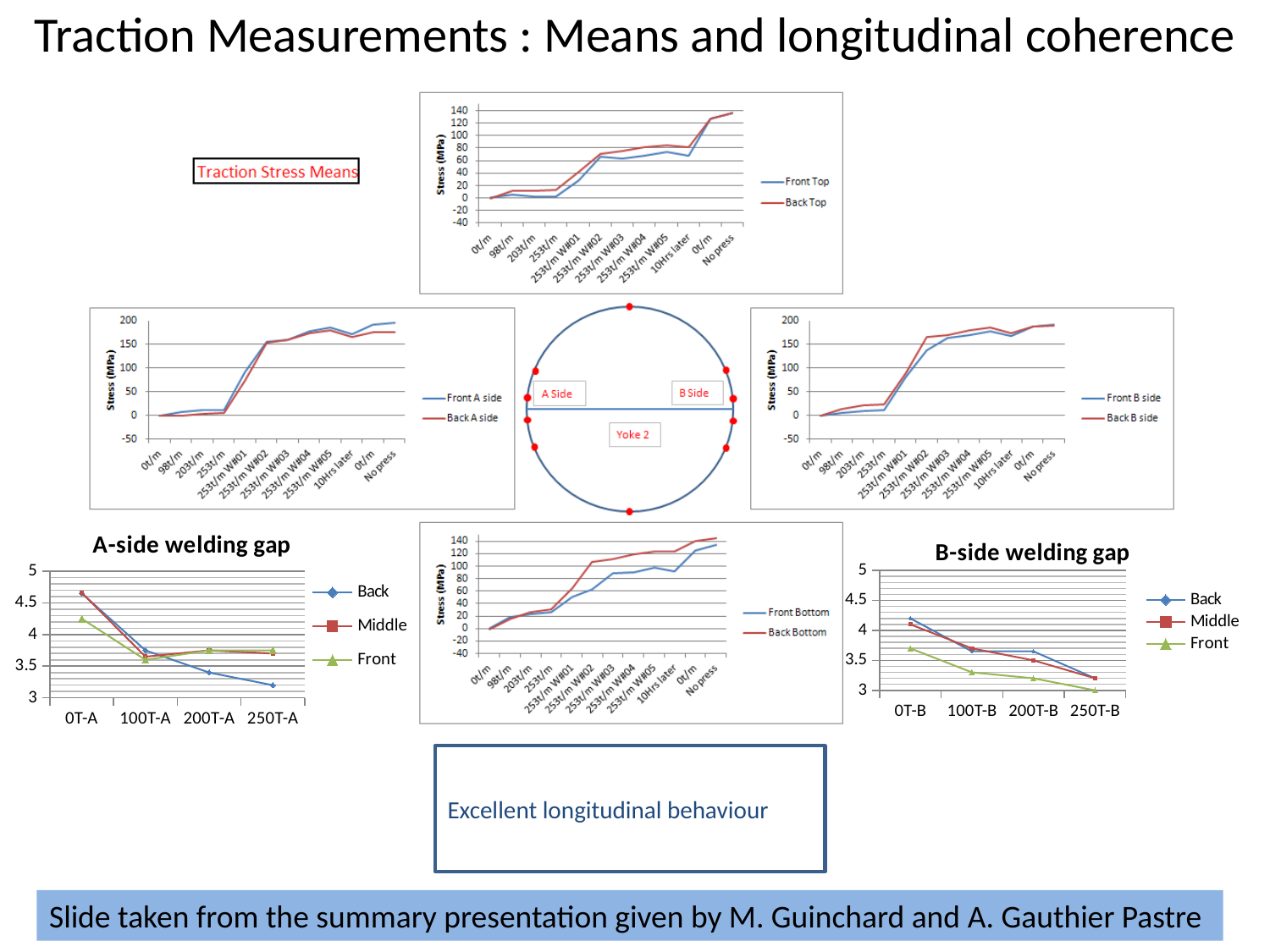
In the left stress chart with Front A side and Back A side, is the value for Front A side at 'No press' greater or less than 150? greater In the 'A-side welding gap' chart, is the value for Back at 250T-A greater or less than 3.5? less In the top stress chart with Front Top and Back Top, is the value for Back Top at 'No press' greater or less than 120? greater In the bottom-centre stress chart with Front Bottom and Back Bottom, do the values for Back Bottom generally rise or fall along the x axis? rise Which two series does the legend of the top stress chart (Stress (MPa) vs load steps) list? Front Top and Back Top In the 'B-side welding gap' chart, do the values for Back rise or fall from 0T-B to 250T-B? fall What kind of chart is the 'A-side welding gap' chart? line chart How many categories are shown on the x axis of the 'A-side welding gap' chart? 4 How many series does the legend of the 'B-side welding gap' chart list? 3